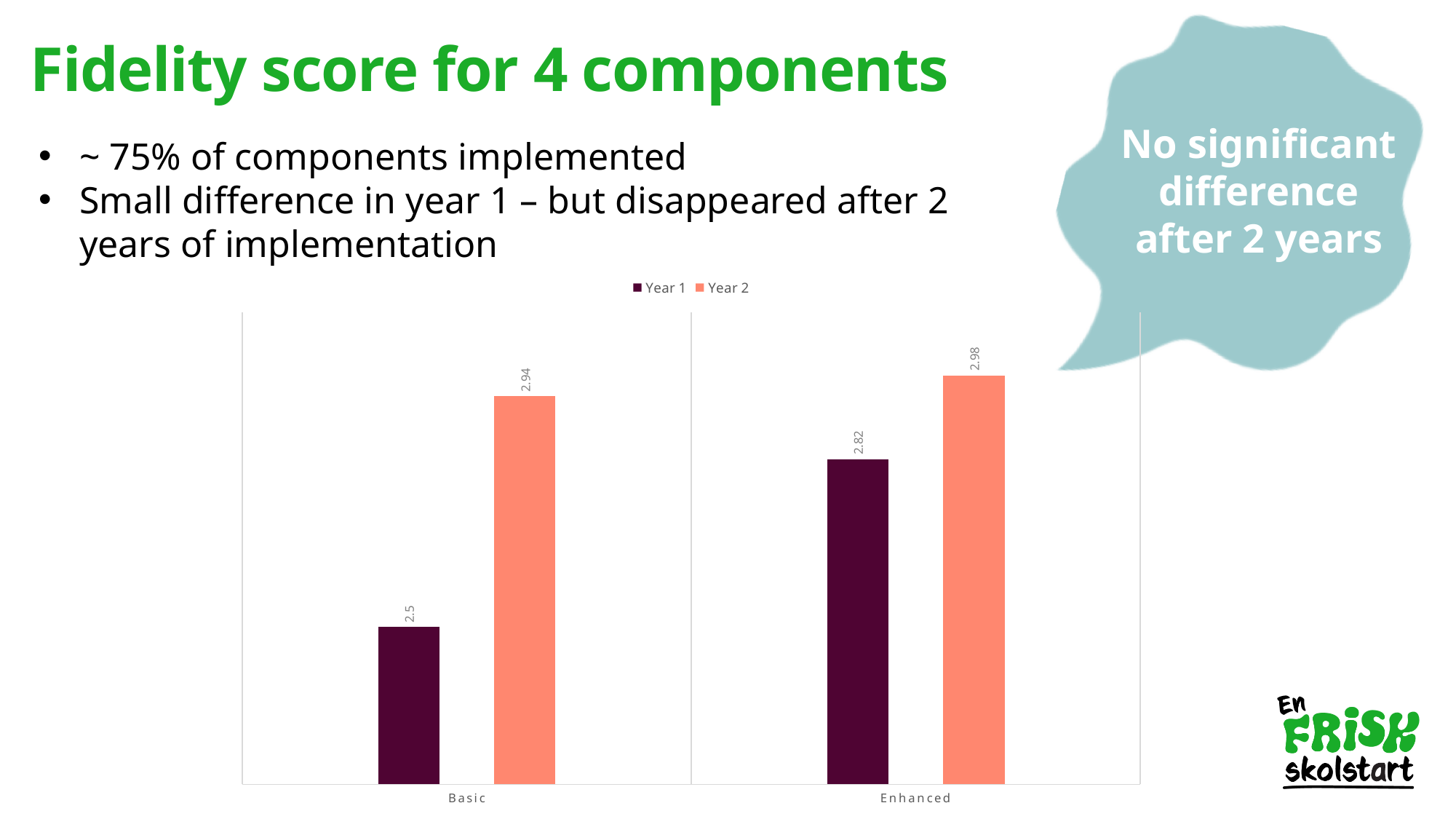
What is the Year 2 value for Enhanced? 2.98 How many categories are shown on the x axis? 2 How many series does the legend list? 2 What is the Year 1 value for Enhanced? 2.82 What is the difference between the Year 2 and Year 1 values for Enhanced? 0.16 What kind of chart is shown on the slide? Bar chart What is the Year 2 value for Basic? 2.94 Which bar has the highest value in the chart? Enhanced, Year 2 What is the difference between the Year 2 and Year 1 values for Basic? 0.44 What is the Year 1 value for Basic? 2.5 Which is larger for Year 1: Basic or Enhanced? Enhanced Which bar has the lowest value in the chart? Basic, Year 1